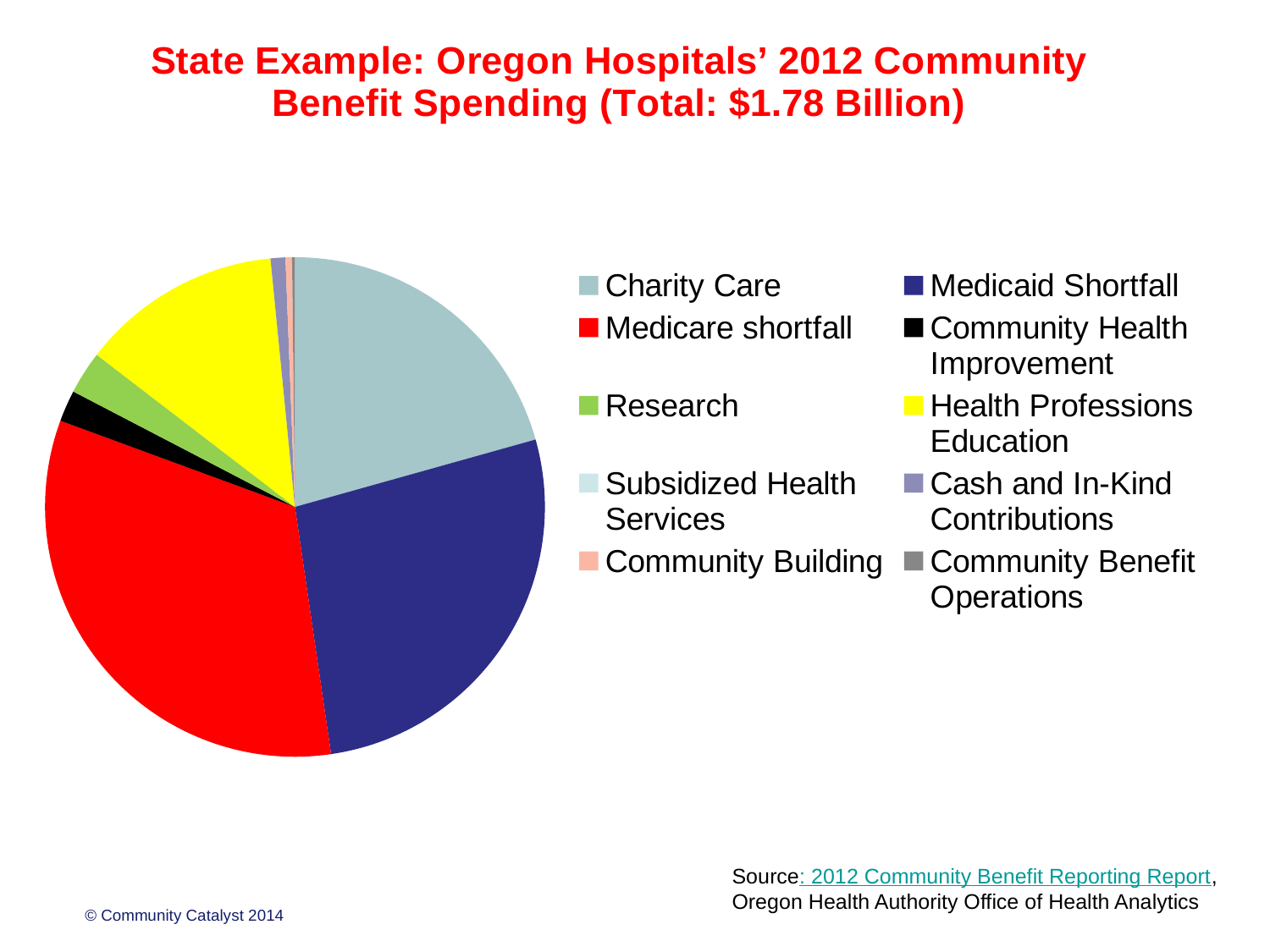
Which slice is larger, Charity Care or Research? Charity Care What kind of chart is shown on the slide? Pie chart What colour is the Medicare shortfall slice in the pie chart? Red How many categories does the pie chart's legend list? 10 Which slice is larger, Research or Medicaid Shortfall? Medicaid Shortfall Which category has the largest slice of the pie chart? Medicare shortfall Which slice is larger, Charity Care or Health Professions Education? Charity Care What total spending amount is stated in the chart's title? $1.78 Billion